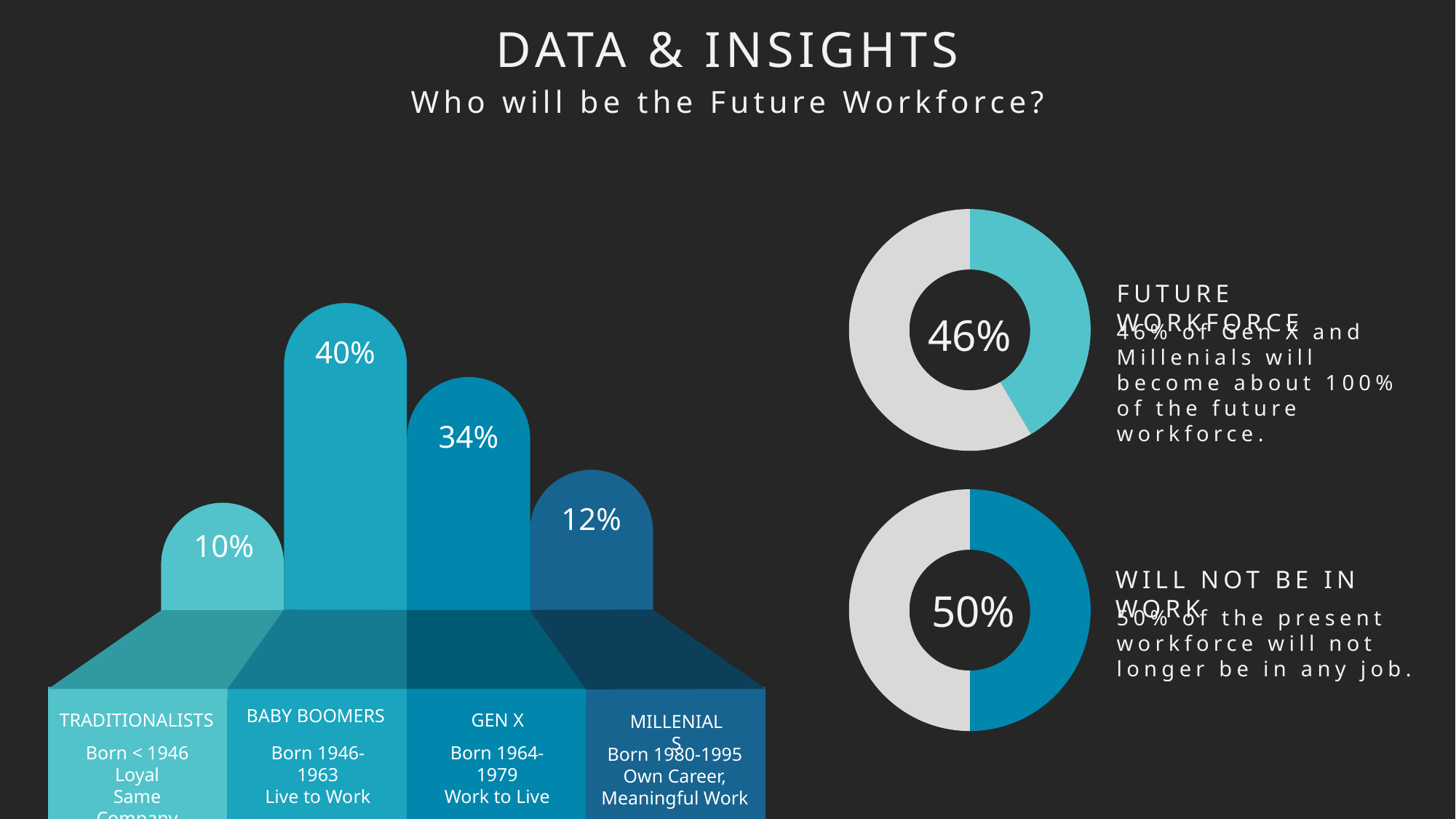
In the bar chart on the left, what is the value for Baby Boomers? 40% What kind of chart is used on the left side of the slide to show the generations? Bar chart In the bar chart on the left, what is the difference between the values for Baby Boomers and Gen X? 6% In the bottom donut chart on the right, labelled 'Will not be in work', what percentage is shown? 50% In the bar chart on the left, what is the value for Gen X? 34% In the bar chart on the left, what is the value for Traditionalists? 10% In the bar chart on the left, which is larger, the value for Millennials or the value for Traditionalists? Millennials In the top donut chart on the right, what percentage is shown in the centre? 46% What is the title of the slide? Data & Insights How many generation categories are shown in the bar chart on the left? 4 In the bar chart on the left, which generation has the lowest value? Traditionalists In the bar chart on the left, which generation has the highest value? Baby Boomers